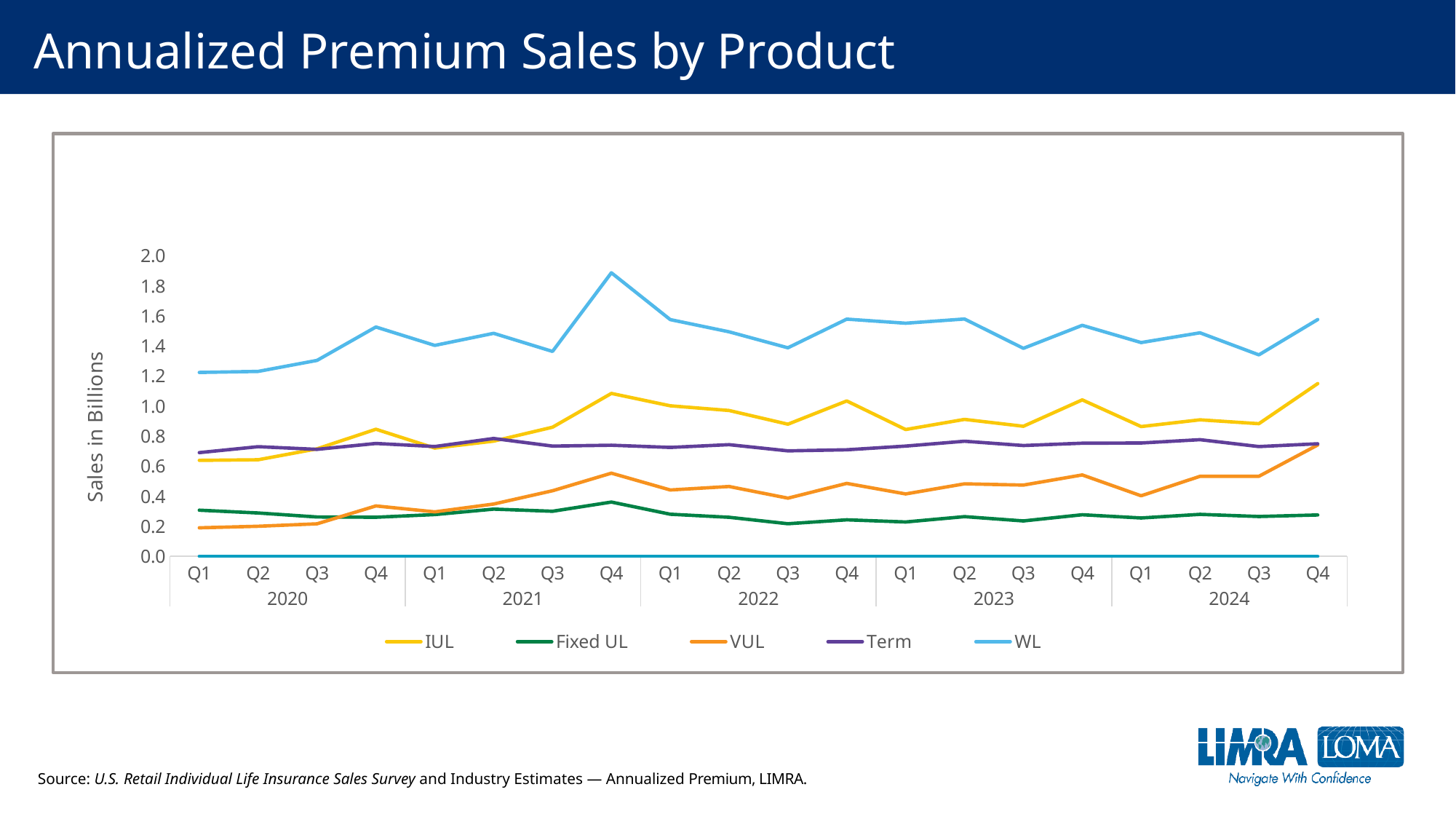
Which product series has the highest values across the whole chart? WL How many quarterly data points are plotted along the x axis for each series? 20 Which is larger in Q1 2022, Term or VUL? Term In which quarter does the WL series reach its peak? Q4 2021 Which is larger in Q4 2021, WL or IUL? WL What kind of chart is shown on the slide? line chart How many series does the legend list? 5 Is the value for WL in Q4 2021 greater or less than 1.6? greater Is the value for VUL in Q1 2020 greater or less than 0.4? less Is the value for IUL in Q4 2024 greater or less than 1.0? greater What is the label on the y axis? Sales in Billions Does the IUL series overall rise or fall from Q1 2020 to Q4 2024? rise